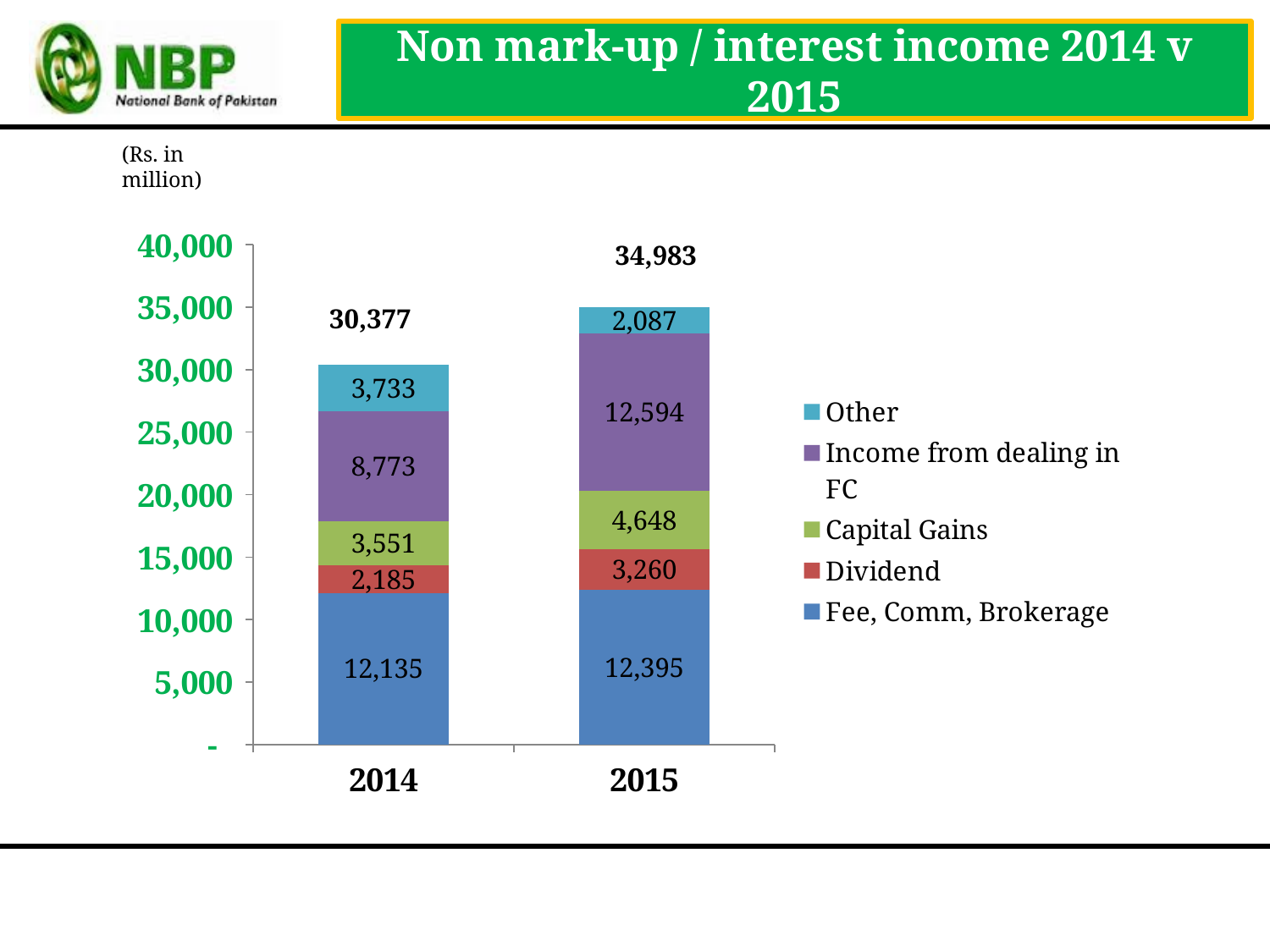
What is the total of the stacked bar for 2014? 30,377 What is the total of the stacked bar for 2015? 34,983 Which series has the highest value in 2014? Fee, Comm, Brokerage What is the difference between the Fee, Comm, Brokerage values for 2015 and 2014? 260 Which year has the larger value for Other, 2014 or 2015? 2014 What is the value for Income from dealing in FC in 2015? 12,594 What is the value for Capital Gains in 2015? 4,648 How many series does the legend list? 5 Which series has the lowest value in 2015? Other What kind of chart is shown on the slide? Stacked bar chart What unit is stated for the values in the chart? Rs. in million What is the value for Dividend in 2014? 2,185